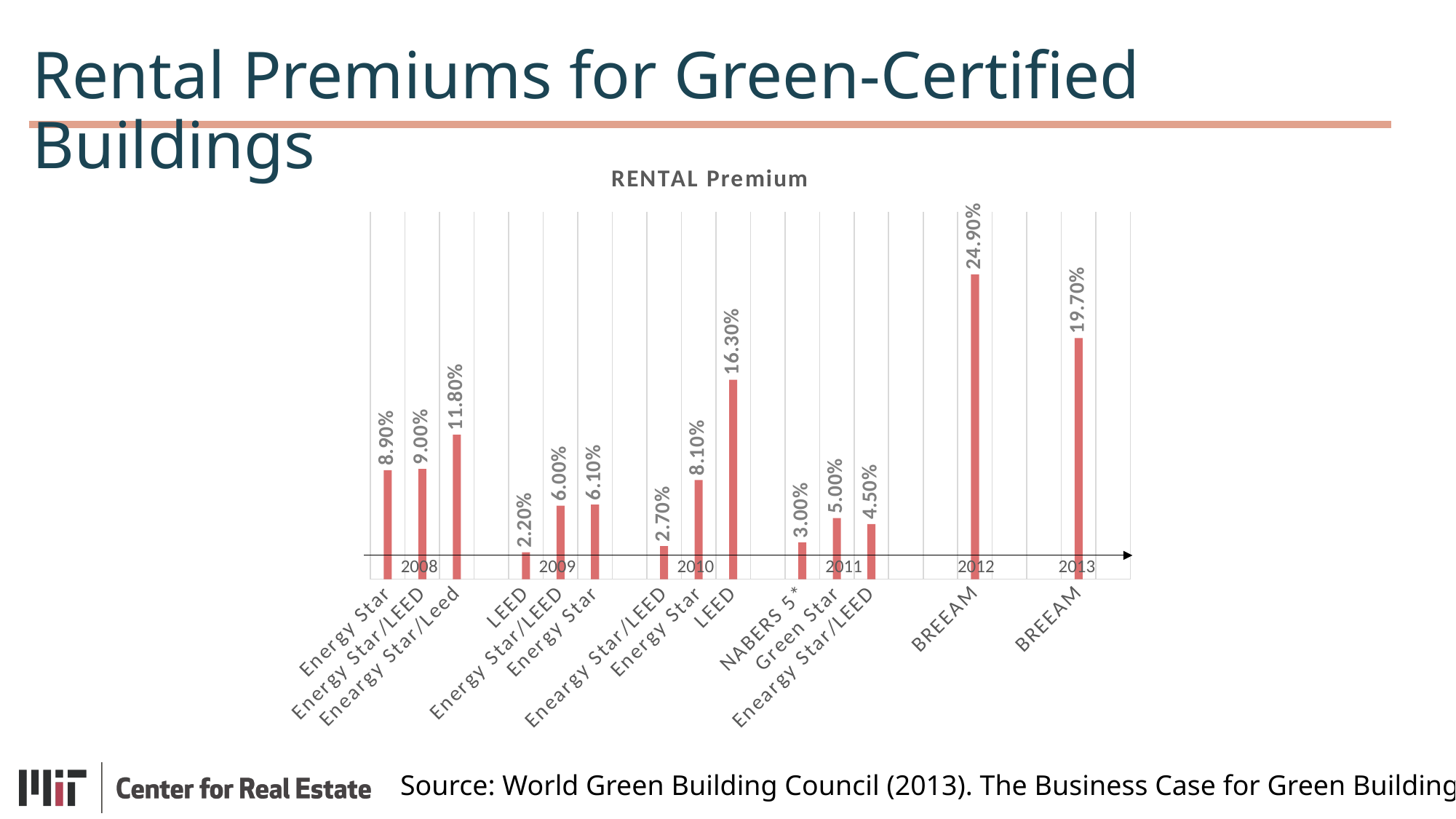
What is the rental premium for BREEAM in 2012? 24.90% How many bars are plotted in the chart? 14 What is the rental premium for LEED in 2010? 16.30% What type of chart is shown on the slide? Bar chart What is the rental premium for LEED in 2009? 2.20% Which bar has the highest rental premium? BREEAM (2012) Which bar has the lowest rental premium? LEED (2009) What is the title of the chart? RENTAL Premium What is the rental premium for NABERS 5* in 2011? 3.00% What is the difference between the BREEAM rental premium in 2012 and in 2013? 5.20% What is the difference between the rental premium for LEED in 2010 and Energy Star in 2010? 8.20% Which is larger: the rental premium for Green Star in 2011 or for Energy Star in 2010? Energy Star in 2010